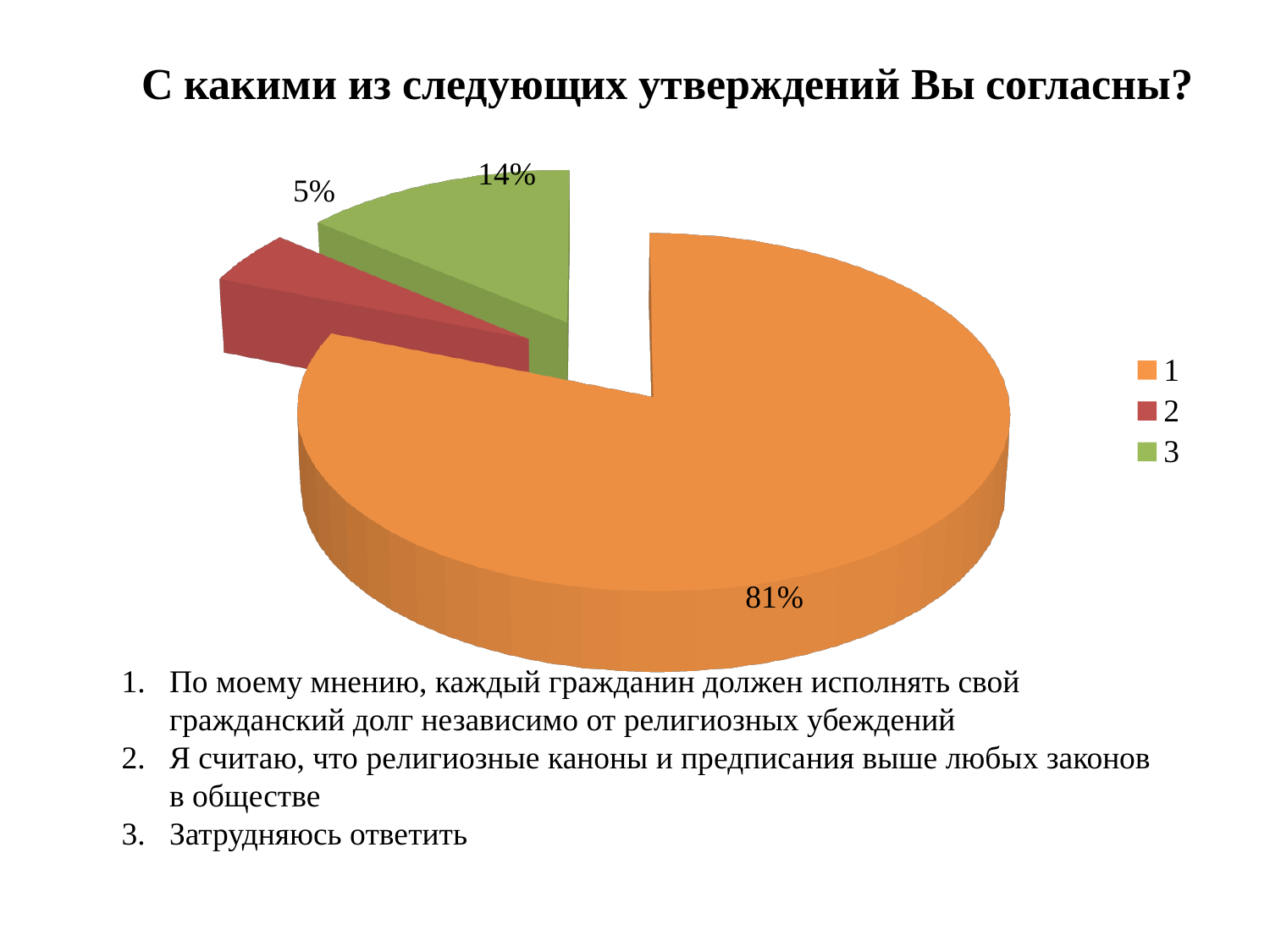
What share of the pie does category 3 have? 14% Which category has the smallest slice of the pie? 2 What share of the pie does category 2 have? 5% Which category has the largest slice of the pie? 1 Which is larger, the slice for category 3 or the slice for category 2? 3 What kind of chart is shown on the slide? pie chart How many slices does the pie chart have? 3 What is the title of the chart? С какими из следующих утверждений Вы согласны? What is the difference in percentage points between category 3 and category 2? 9 What colour is the slice for category 1? orange How many entries does the legend list? 3 What share of the pie does category 1 have? 81%